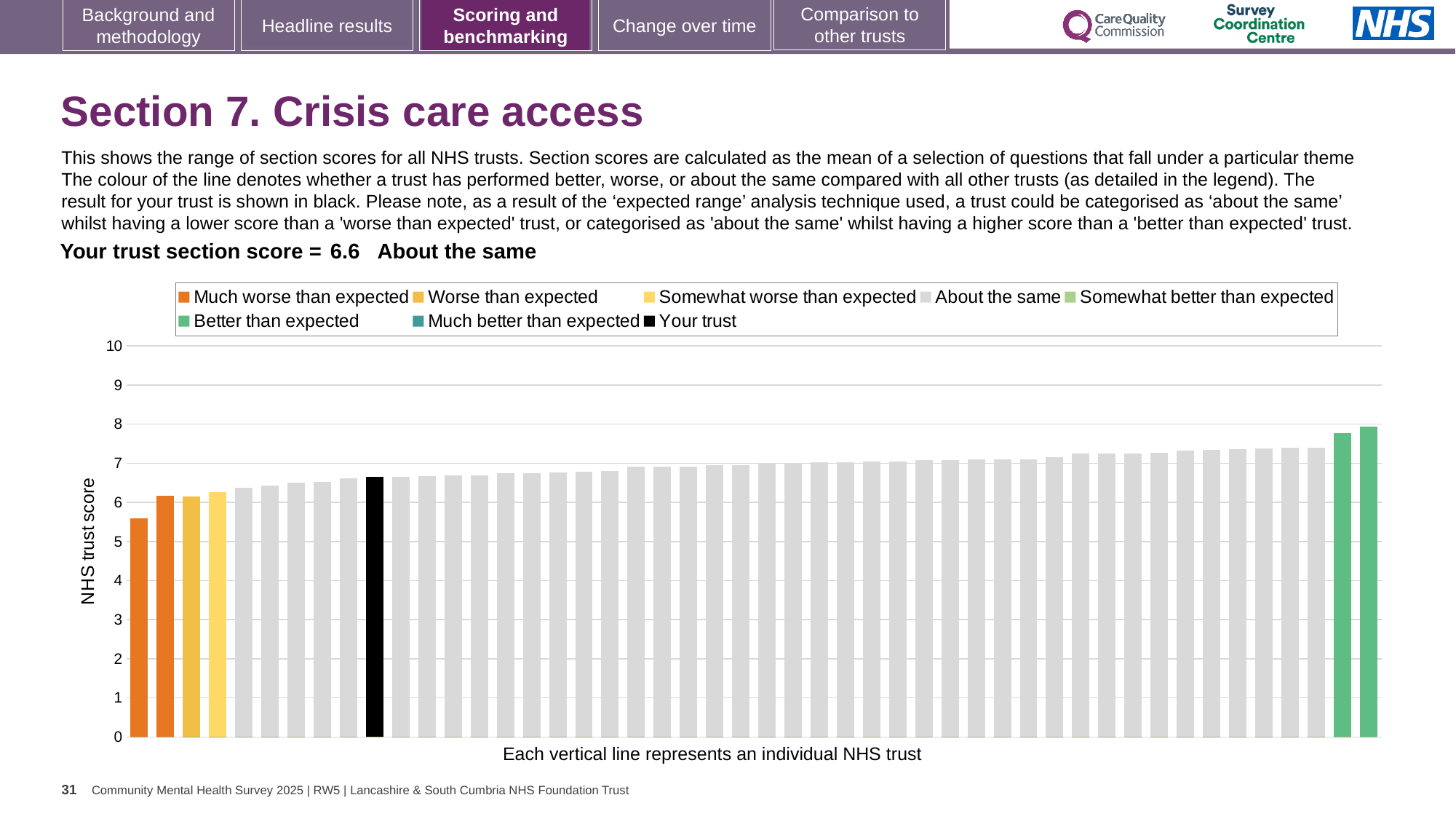
What is the section score for your trust shown on the slide? 6.6 Is the value of the leftmost (lowest) bar greater or less than 6? less Which legend category do the highest bars on the chart belong to? Better than expected Is the value of the black 'Your trust' bar greater or less than 7? less How many bars are coloured as 'Better than expected' (green)? 2 How many entries does the chart legend list? 8 What kind of chart is shown on the slide? bar chart What is the label on the vertical axis of the chart? NHS trust score How many bars are coloured as 'Much worse than expected' (orange)? 2 Do the bar values rise or fall from left to right along the x axis? rise Which legend category does the lowest bar on the chart belong to? Much worse than expected